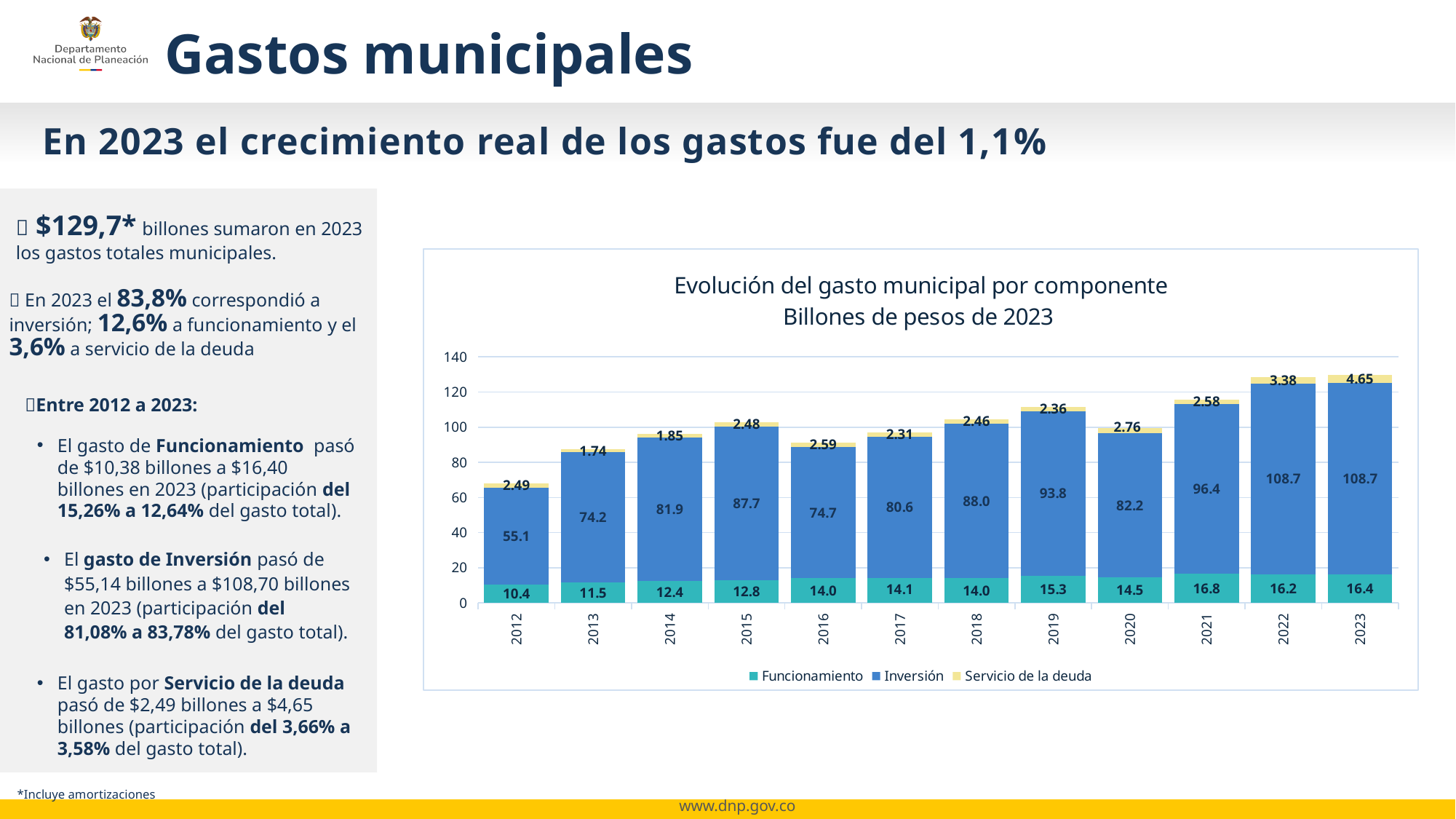
In which year is the Inversión value lowest? 2012 What is the Inversión value for 2019? 93.8 How many series does the legend list? 3 What is the Servicio de la deuda value for 2023? 4.65 What is the difference between the Inversión value in 2023 and in 2012? 53.6 Which year has the larger Inversión value, 2016 or 2020? 2020 In which year is the Funcionamiento value highest? 2021 What is the Funcionamiento value for 2021? 16.8 How many years are shown on the x axis? 12 What is the total of the stacked bar for 2012? 67.99 Is the total height of the stacked bar for 2023 greater or less than 120? greater What kind of chart is shown on the slide? Stacked bar chart